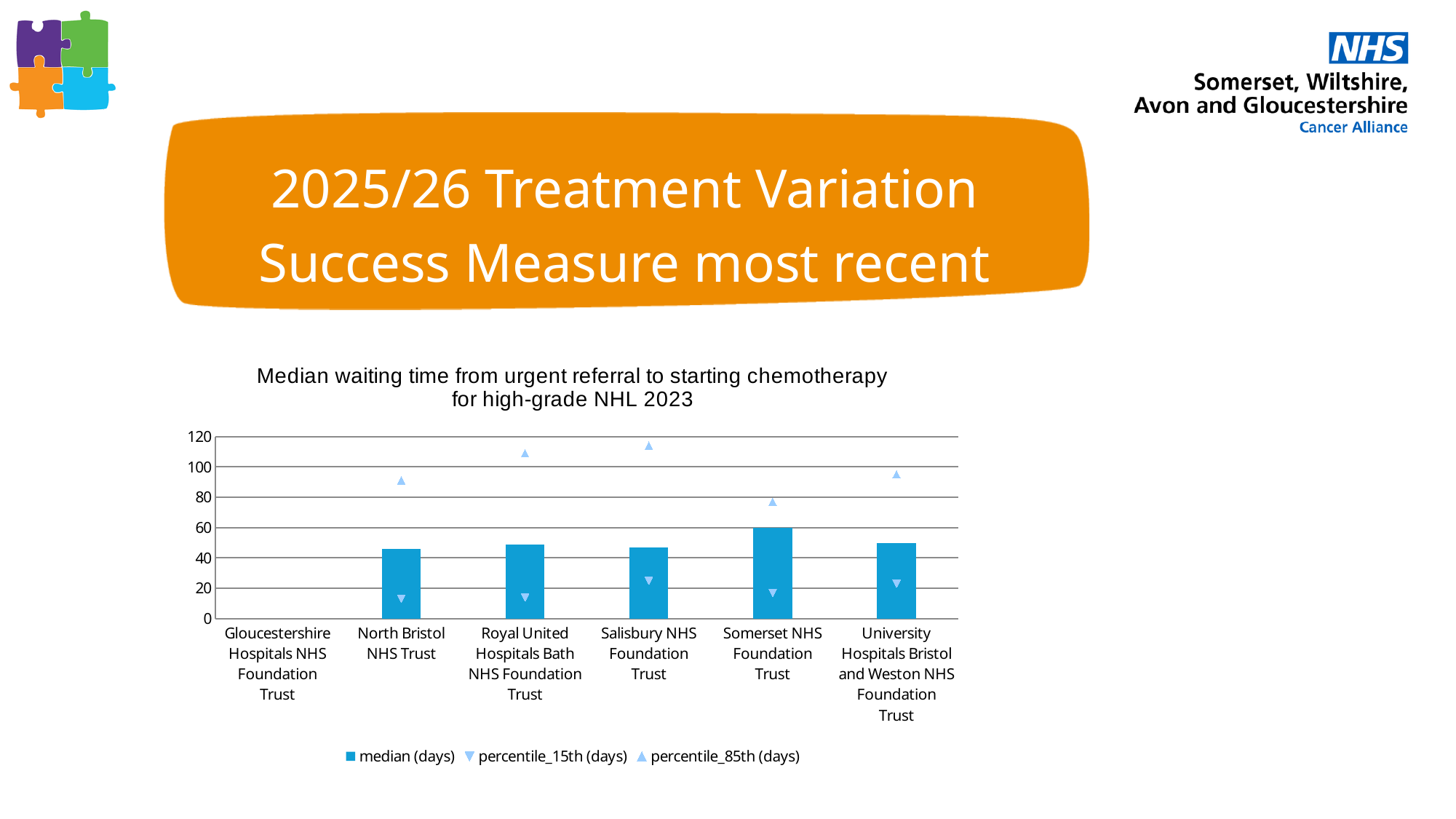
What is the title of the chart? Median waiting time from urgent referral to starting chemotherapy for high-grade NHL 2023 Which trust has the highest percentile_85th (days) marker? Salisbury NHS Foundation Trust Is the percentile_15th (days) value for North Bristol NHS Trust greater or less than 20? less Is the median (days) value for North Bristol NHS Trust greater or less than 60? less How many series does the chart legend list? 3 Is the median (days) value for Somerset NHS Foundation Trust greater or less than 40? greater Which trust has the highest median (days) bar? Somerset NHS Foundation Trust Which trust has the lowest percentile_85th (days) marker? Somerset NHS Foundation Trust Which has the larger percentile_85th (days) value: Royal United Hospitals Bath NHS Foundation Trust or University Hospitals Bristol and Weston NHS Foundation Trust? Royal United Hospitals Bath NHS Foundation Trust How many trusts are listed along the x axis of the chart? 6 What kind of chart is shown on the slide? bar chart